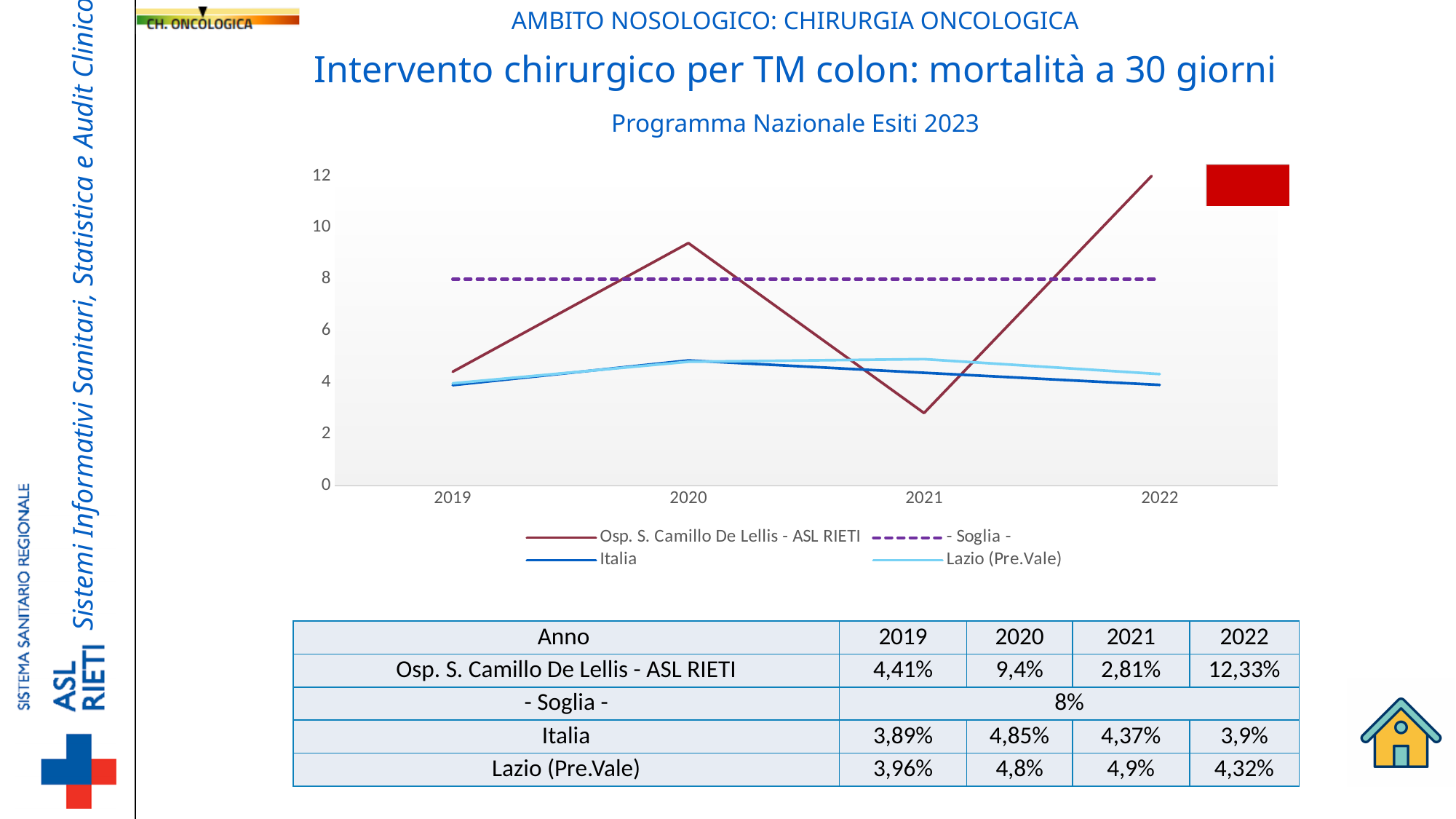
Which is larger in 2021: the value for Italia or the value for Lazio (Pre.Vale)? Lazio (Pre.Vale) How many years are plotted along the x axis of the chart? 4 Does the Osp. S. Camillo De Lellis - ASL RIETI line rise or fall from 2021 to 2022? rise In which year is the value for Osp. S. Camillo De Lellis - ASL RIETI highest? 2022 How many series does the chart legend list? 4 Is the value for Osp. S. Camillo De Lellis - ASL RIETI in 2020 greater or less than 8? greater What is the value of the Soglia threshold line? 8% What is the value for Italia in 2020? 4,85% What is the difference between the Osp. S. Camillo De Lellis - ASL RIETI value in 2022 and in 2021? 9,52% What is the value for Osp. S. Camillo De Lellis - ASL RIETI in 2022? 12,33% In which year is the value for Osp. S. Camillo De Lellis - ASL RIETI lowest? 2021 What kind of chart is shown on the slide? line chart